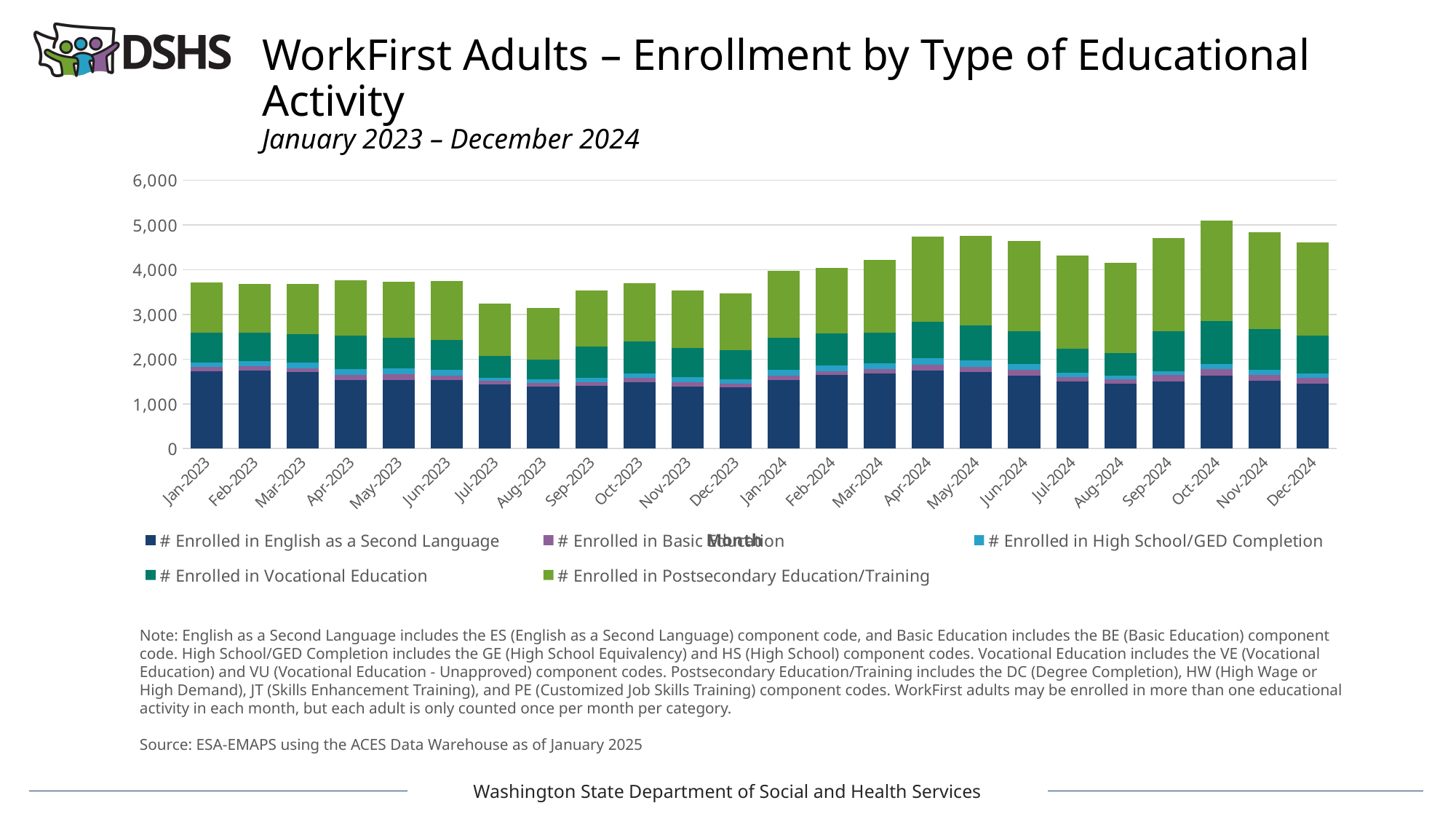
Which series is shown in light green at the top of each stacked bar? # Enrolled in Postsecondary Education/Training Which month has the highest total enrollment bar? Oct-2024 Do the total enrollment bars rise or fall from Dec-2023 to Apr-2024? rise What kind of chart is shown on the slide? Stacked bar chart How many series does the chart's legend list? 5 Is the total enrollment bar for Aug-2023 greater or less than 4,000? less Is the total enrollment bar for Apr-2024 greater or less than 4,000? greater How many months are plotted along the x axis of the chart? 24 Which has the larger total enrollment bar, Aug-2023 or Apr-2024? Apr-2024 Is the total enrollment bar for Oct-2024 greater or less than 5,000? greater What is the title of the chart on the slide? WorkFirst Adults – Enrollment by Type of Educational Activity Which has the larger total enrollment bar, Jan-2023 or Oct-2024? Oct-2024